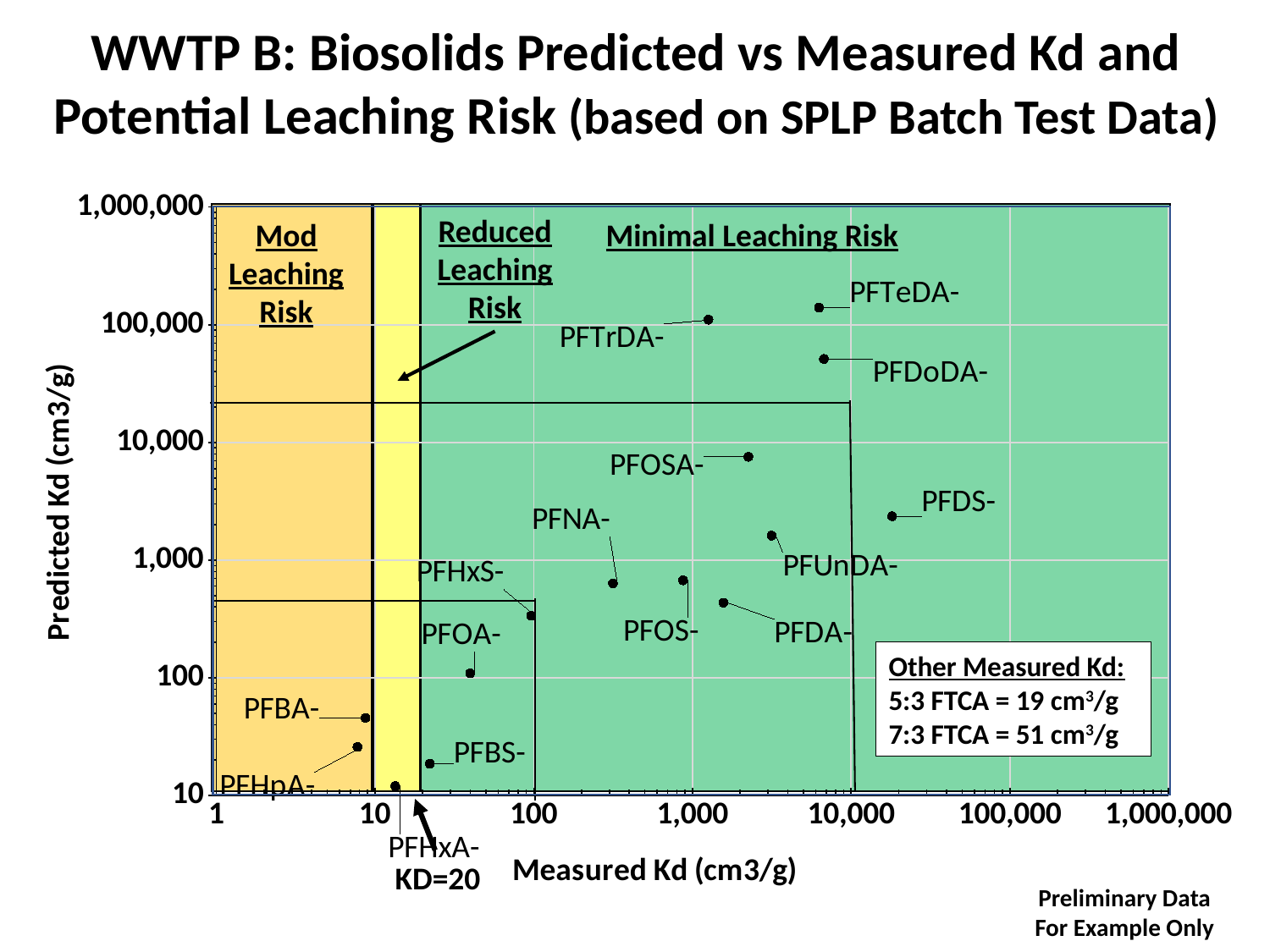
What is the title of the x axis? Measured Kd (cm3/g) According to the text box, what is the measured Kd for 5:3 FTCA? 19 cm3/g Which compound has the lowest predicted Kd? PFHxA- What is the title of the y axis? Predicted Kd (cm3/g) Is the predicted Kd for PFOSA- greater or less than 10,000? less Which compound has the highest measured Kd? PFDS- What kind of chart is shown on the slide? scatter plot Which compound has the highest predicted Kd? PFTeDA- Is the measured Kd for PFDS- greater or less than 10,000? greater Is the predicted Kd for PFTeDA- greater or less than 100,000? greater Which has the higher predicted Kd, PFOSA- or PFDS-? PFOSA-